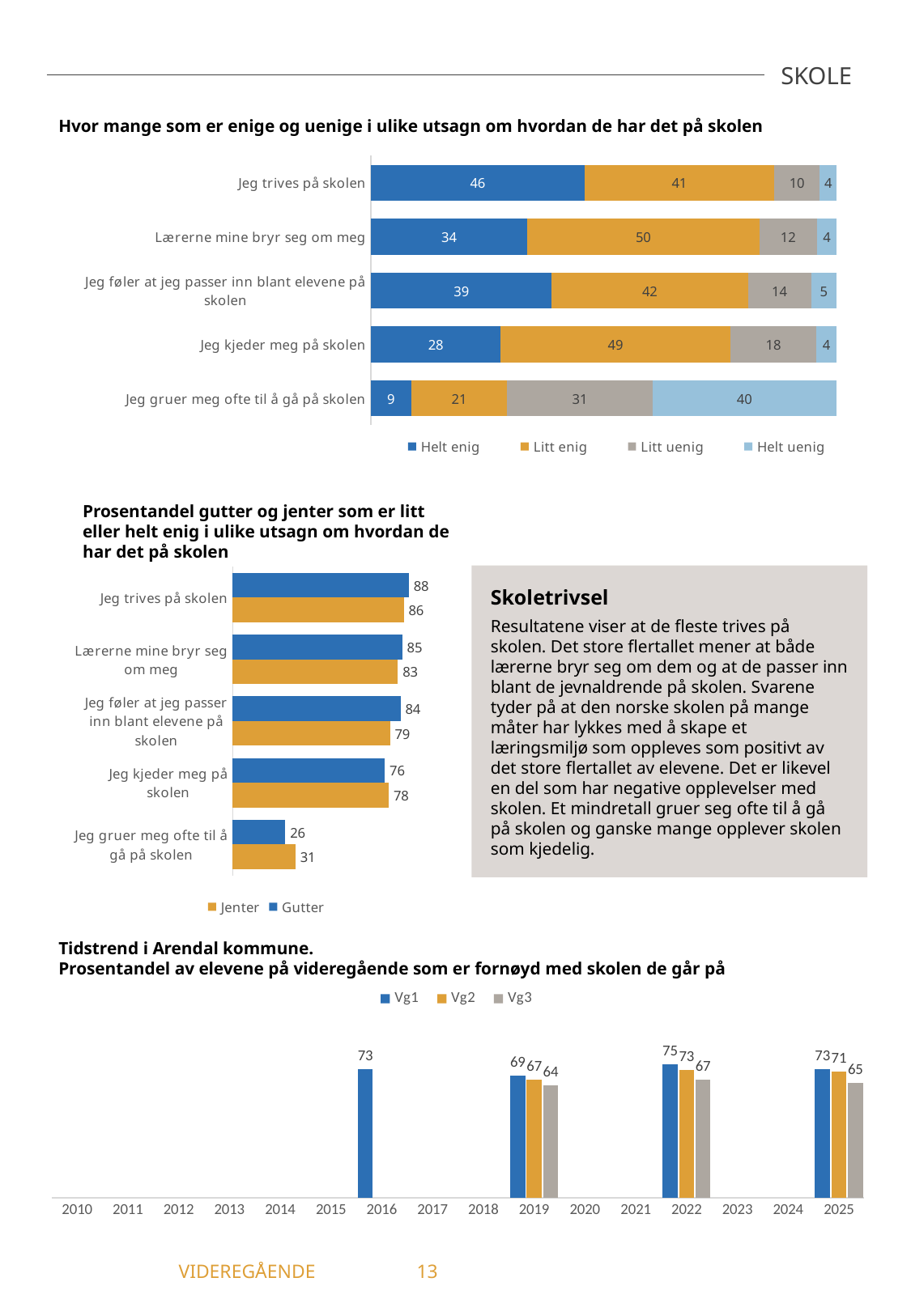
In the chart 'Hvor mange som er enige og uenige i ulike utsagn om hvordan de har det på skolen', what is the total of the stacked bar for 'Jeg kjeder meg på skolen'? 99 In the chart 'Hvor mange som er enige og uenige i ulike utsagn om hvordan de har det på skolen', how many series does the legend list? 4 In the chart 'Prosentandel gutter og jenter som er litt eller helt enig i ulike utsagn om hvordan de har det på skolen', what is the difference between Jenter and Gutter for 'Jeg gruer meg ofte til å gå på skolen'? 5 In the chart 'Hvor mange som er enige og uenige i ulike utsagn om hvordan de har det på skolen', which statement has the highest 'Litt enig' value? Lærerne mine bryr seg om meg In the chart 'Tidstrend i Arendal kommune', which year has the lowest Vg3 value? 2019 In the chart 'Tidstrend i Arendal kommune', what is the Vg1 value for 2022? 75 In the chart 'Hvor mange som er enige og uenige i ulike utsagn om hvordan de har det på skolen', what is the 'Helt uenig' value for 'Jeg gruer meg ofte til å gå på skolen'? 40 In the chart 'Prosentandel gutter og jenter som er litt eller helt enig i ulike utsagn om hvordan de har det på skolen', how many statements are shown? 5 In the chart 'Hvor mange som er enige og uenige i ulike utsagn om hvordan de har det på skolen', what is the 'Helt enig' value for 'Jeg trives på skolen'? 46 In the chart 'Prosentandel gutter og jenter som er litt eller helt enig i ulike utsagn om hvordan de har det på skolen', which is larger for 'Jeg kjeder meg på skolen': Jenter or Gutter? Jenter In the chart 'Prosentandel gutter og jenter som er litt eller helt enig i ulike utsagn om hvordan de har det på skolen', what is the value for Gutter on 'Jeg trives på skolen'? 88 What kind of chart is 'Tidstrend i Arendal kommune'? Bar chart